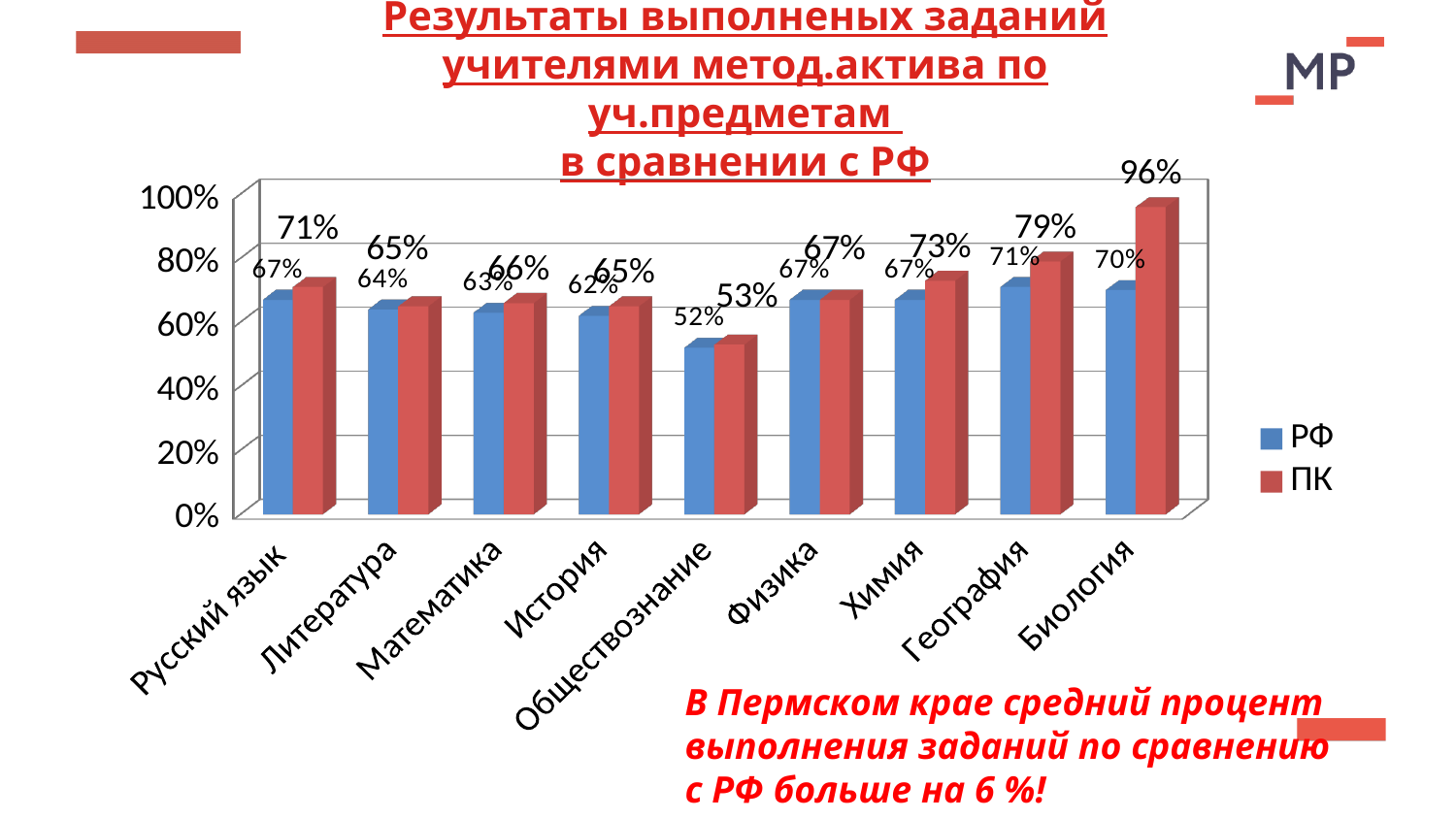
What is the ПК value for Биология? 96% What is the difference between the ПК and РФ values for Химия? 6% What is the РФ value for Русский язык? 67% How many series does the legend list? 2 Which category has the highest ПК value? Биология Which category has the lowest РФ value? Обществознание What is the difference between the ПК and РФ values for Биология? 26% What kind of chart is shown on the slide? Bar chart How many categories are shown on the x axis? 9 What is the РФ value for Обществознание? 52% What is the ПК value for География? 79% Which is larger, the ПК value for География or the ПК value for Химия? География